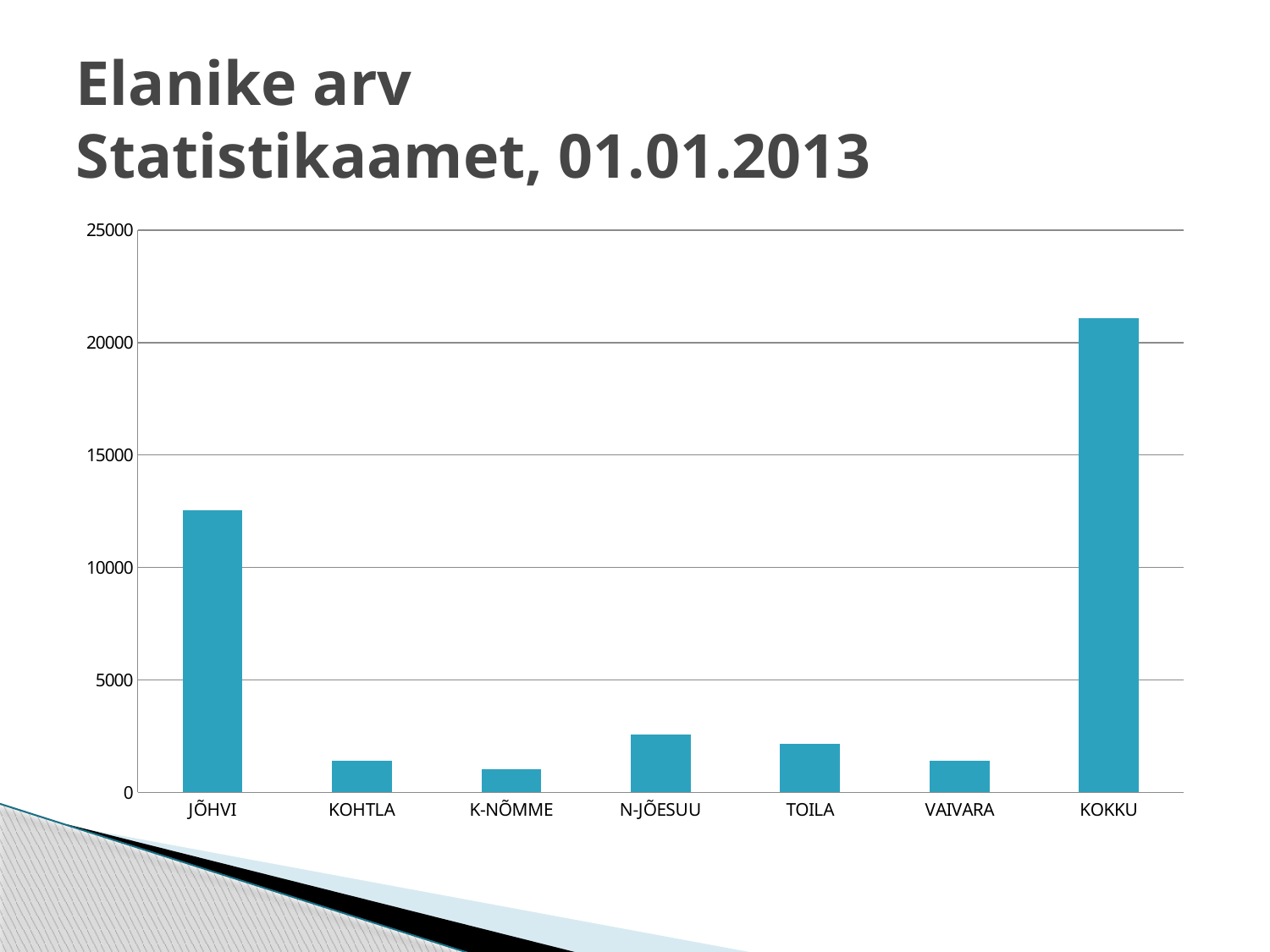
Is the value for JÕHVI greater or less than 15000? less What is the title of the slide containing the chart? Elanike arv Statistikaamet, 01.01.2013 How many categories are shown on the x axis of the chart? 7 Is the value for JÕHVI greater or less than 10000? greater Is the value for N-JÕESUU greater or less than 5000? less Which category has the lowest bar in the chart? K-NÕMME What kind of chart is shown on the slide? bar chart Which is larger, the value for JÕHVI or the value for KOKKU? KOKKU Which is larger, the value for N-JÕESUU or the value for K-NÕMME? N-JÕESUU Which is larger, the value for TOILA or the value for JÕHVI? JÕHVI Which category has the highest bar in the chart? KOKKU